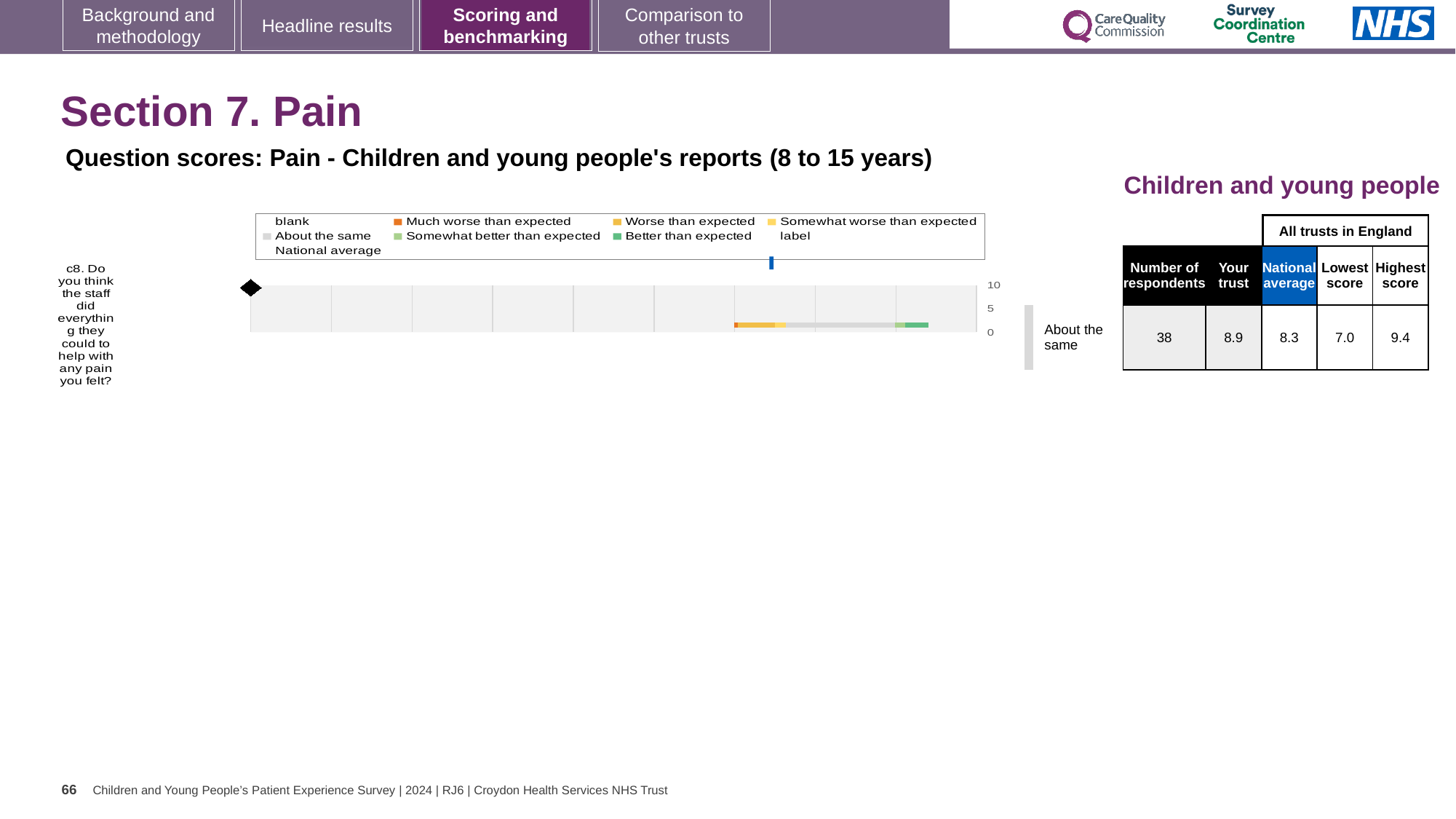
How many survey questions are plotted in the chart? 1 Which question is plotted in the chart? c8. Do you think the staff did everything they could to help with any pain you felt? What is the difference between the highest and lowest scores among all trusts in England for question c8? 2.4 For question c8, which is higher: the trust's score or the national average? Your trust What is the 'Your trust' score for question c8? 8.9 What rating category is shown for question c8? About the same What is the lowest score among all trusts in England for question c8? 7.0 What is the difference between the trust's score and the national average for question c8? 0.6 What is the national average score for question c8? 8.3 What kind of chart is used to show the question score for c8? Bar chart How many respondents answered question c8? 38 What is the highest score among all trusts in England for question c8? 9.4